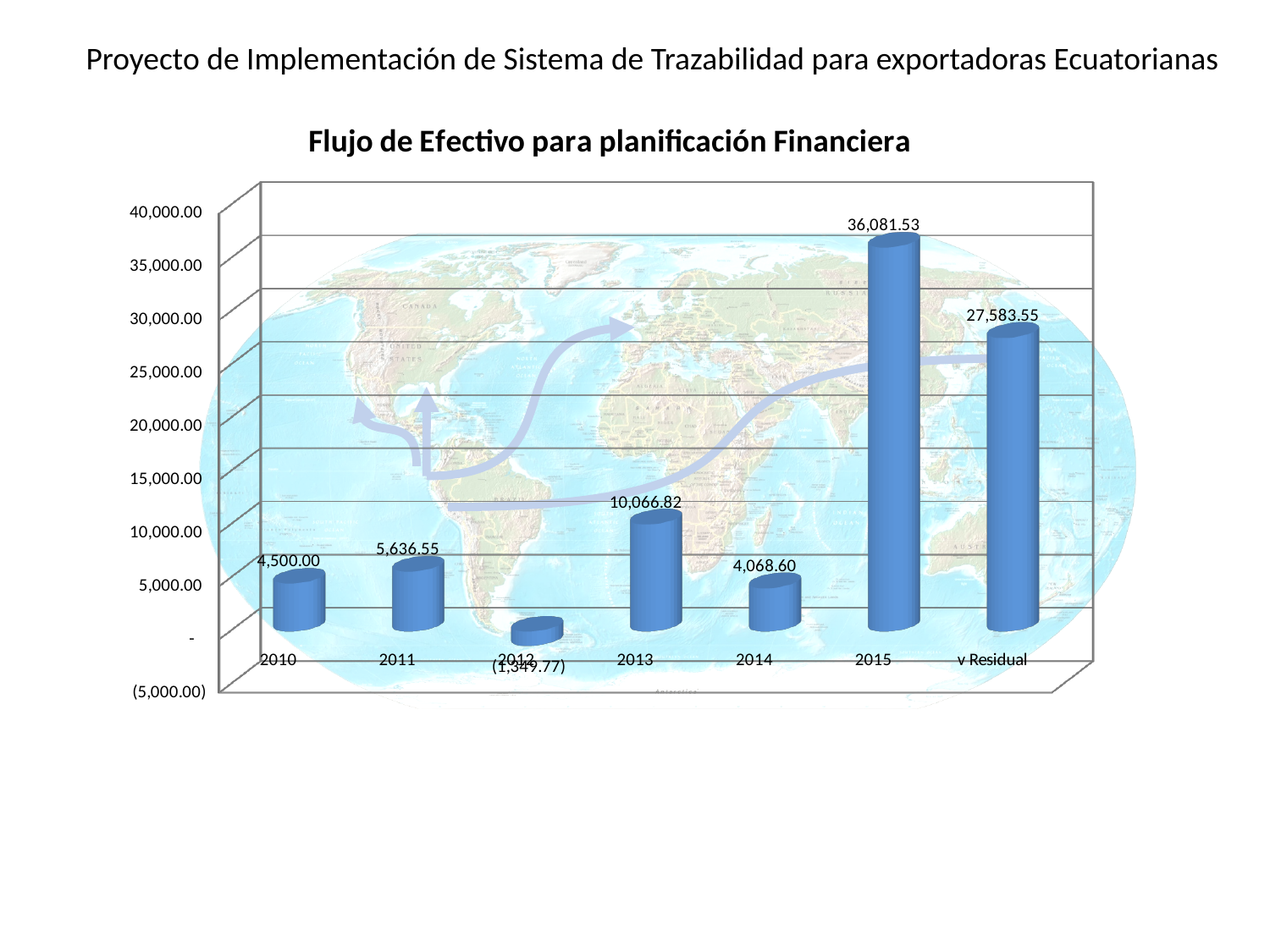
Which category has the highest value? 2015 What is the value for v Residual? 27,583.55 What is the value for 2010? 4,500.00 What is the difference between the values for 2015 and v Residual? 8,497.98 Which is larger, the value for 2013 or the value for 2014? 2013 Which category has the lowest value? 2012 What is the title of the chart? Flujo de Efectivo para planificación Financiera What is the value for 2013? 10,066.82 What is the value for 2015? 36,081.53 What is the difference between the values for 2011 and 2010? 1,136.55 What type of chart is shown on the slide? Bar chart How many categories are shown on the x axis? 7